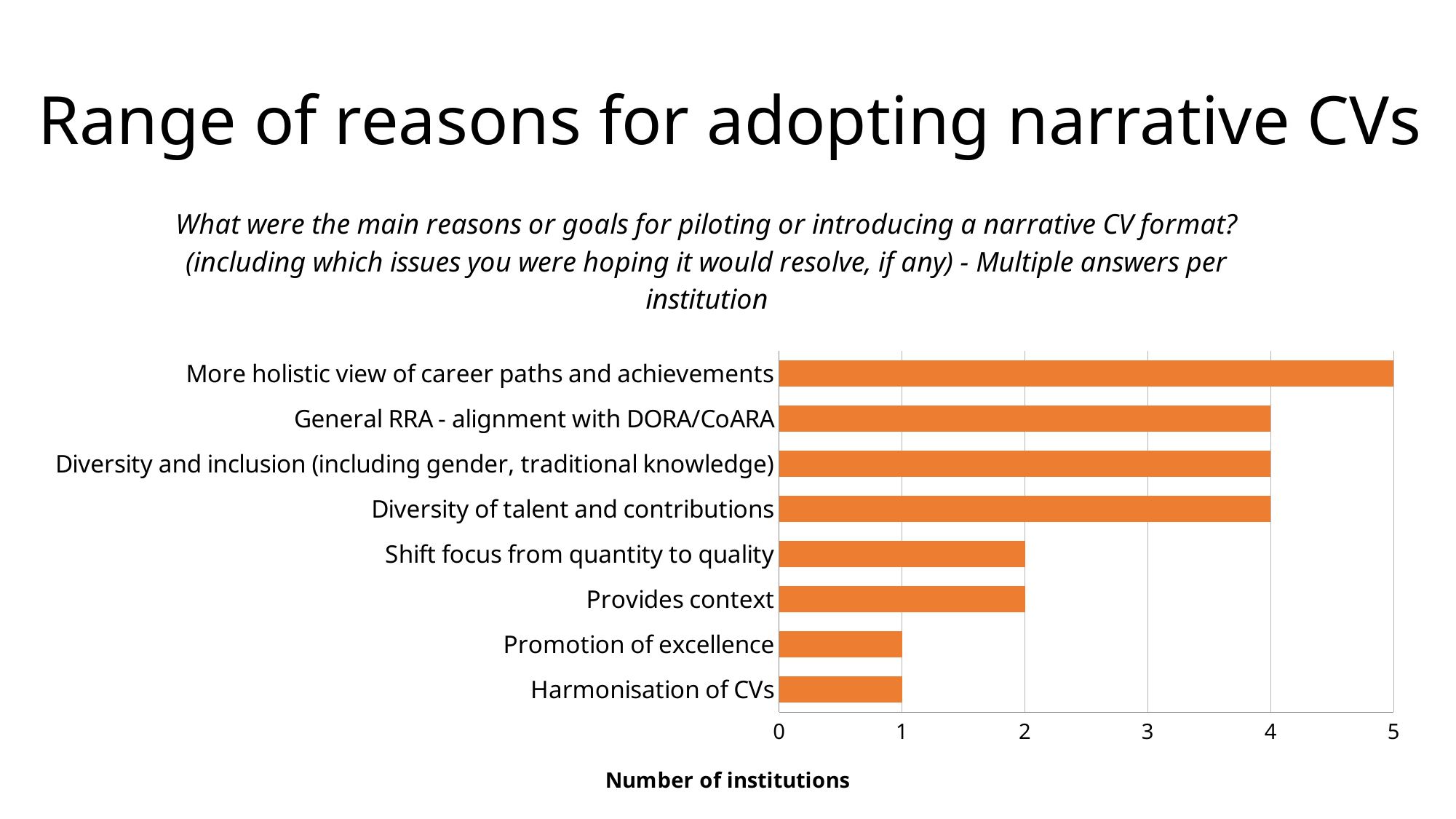
What is the difference in number of institutions between 'More holistic view of career paths and achievements' and 'Promotion of excellence'? 4 What is the label of the horizontal axis? Number of institutions What colour are the bars in the chart? Orange Which reason was cited by the highest number of institutions? More holistic view of career paths and achievements What is the number of institutions for 'Shift focus from quantity to quality'? 2 What type of chart is shown on the slide? Bar chart How many reasons (categories) are listed in the chart? 8 Which has more institutions: 'Diversity of talent and contributions' or 'Provides context'? Diversity of talent and contributions Is the value for 'Provides context' greater or less than 3? less What is the number of institutions for 'General RRA - alignment with DORA/CoARA'? 4 How many institutions cited 'More holistic view of career paths and achievements' as a reason? 5 How many institutions cited 'Harmonisation of CVs'? 1